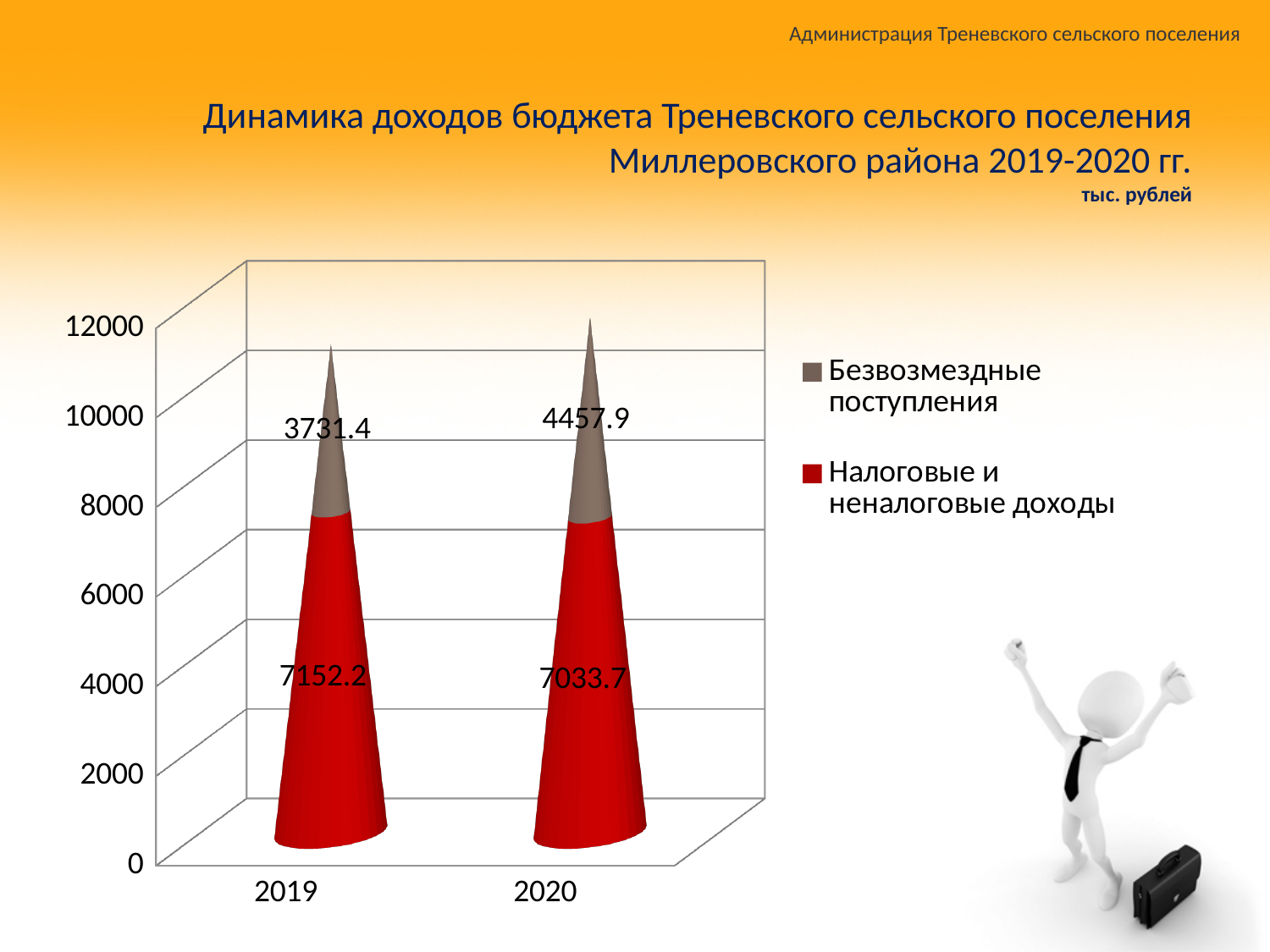
How many years are shown on the x axis? 2 What is the value of Безвозмездные поступления for 2020? 4457.9 What is the value of Безвозмездные поступления for 2019? 3731.4 What is the value of Налоговые и неналоговые доходы for 2020? 7033.7 What is the difference between Безвозмездные поступления in 2020 and in 2019? 726.5 How many series does the legend list? 2 What is the total of the stacked bar for 2020? 11491.6 Which is larger: Налоговые и неналоговые доходы in 2019 or in 2020? 2019 What is the value of Налоговые и неналоговые доходы for 2019? 7152.2 What is the total of the stacked bar for 2019? 10883.6 In which year is Безвозмездные поступления higher? 2020 What kind of chart is shown on the slide? Stacked bar chart